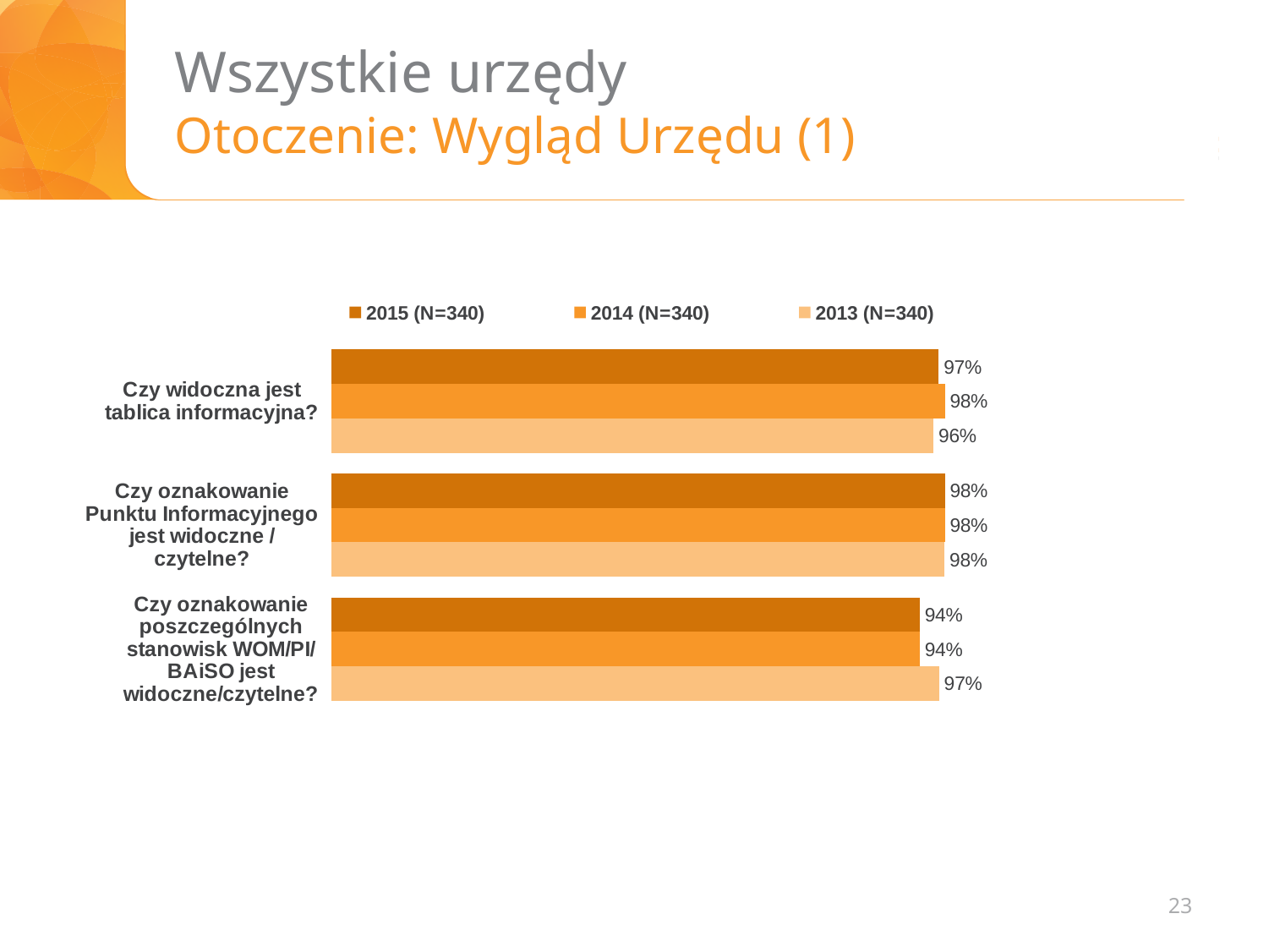
What kind of chart is shown on the slide? Bar chart What is the difference between the 2013 and 2015 values for "Czy oznakowanie poszczególnych stanowisk WOM/PI/BAiSO jest widoczne/czytelne?"? 3 percentage points What is the 2013 (N=340) value for "Czy widoczna jest tablica informacyjna?"? 96% How many questions (categories) are shown in the chart? 3 What is the 2013 (N=340) value for "Czy oznakowanie poszczególnych stanowisk WOM/PI/BAiSO jest widoczne/czytelne?"? 97% What is the 2015 (N=340) value for "Czy oznakowanie poszczególnych stanowisk WOM/PI/BAiSO jest widoczne/czytelne?"? 94% Which question has the highest 2013 (N=340) value? Czy oznakowanie Punktu Informacyjnego jest widoczne / czytelne? What is the 2014 (N=340) value for "Czy oznakowanie Punktu Informacyjnego jest widoczne / czytelne?"? 98% Which question has the lowest 2015 (N=340) value? Czy oznakowanie poszczególnych stanowisk WOM/PI/BAiSO jest widoczne/czytelne? For "Czy widoczna jest tablica informacyjna?", which year has the larger value, 2014 or 2013? 2014 How many series does the legend list? 3 What is the 2015 (N=340) value for "Czy widoczna jest tablica informacyjna?"? 97%